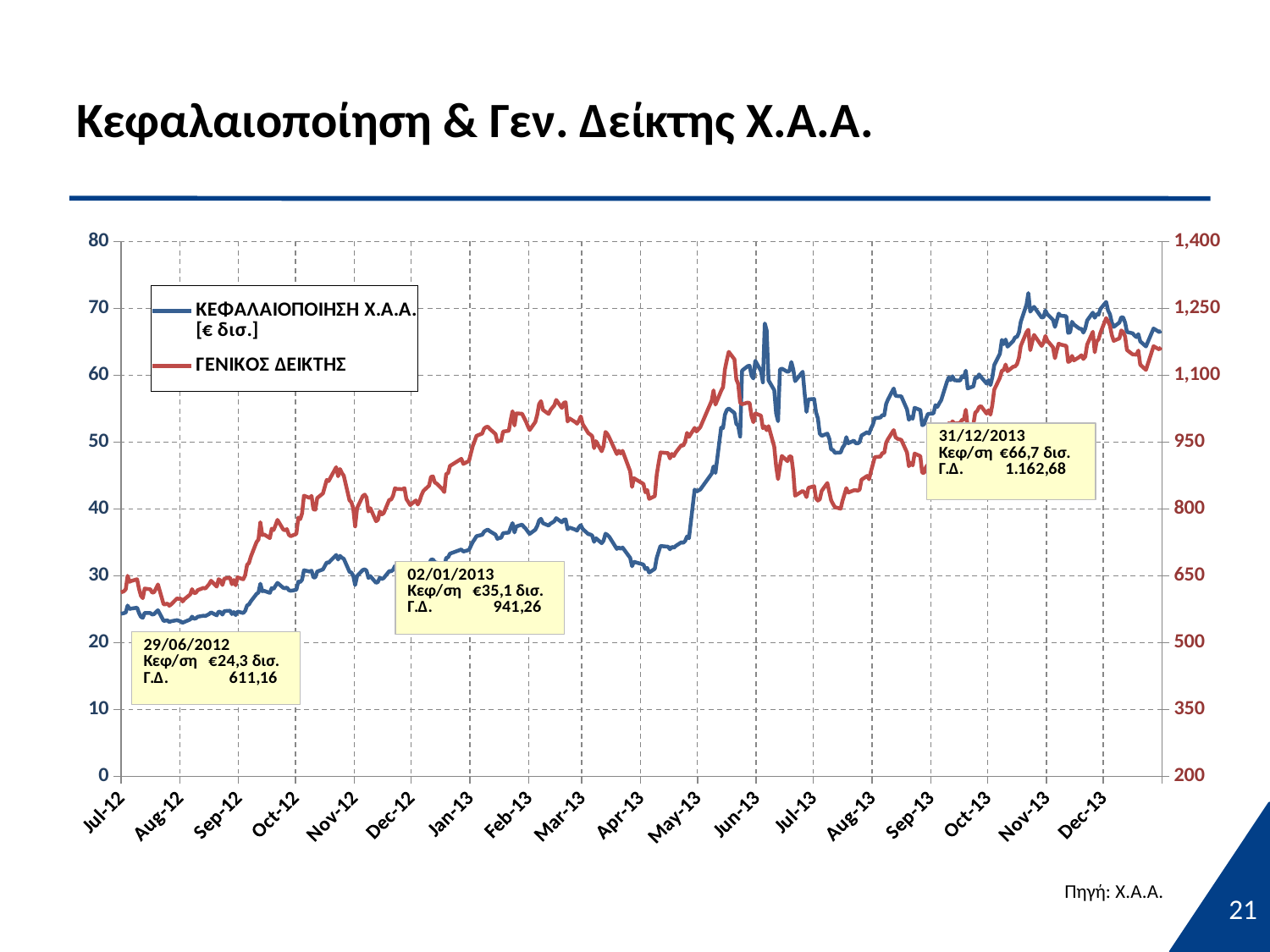
What was the General Index (Γ.Δ.) value on 02/01/2013 according to the annotation? 941,26 Which series is drawn in red in the chart? ΓΕΝΙΚΟΣ ΔΕΙΚΤΗΣ How many series does the legend list? 2 What was the capitalisation (Κεφ/ση) on 29/06/2012 according to the annotation? €24,3 δισ. Overall, does the ΚΕΦΑΛΑΙΟΠΟΙΗΣΗ Χ.Α.Α. line rise or fall from Jul-12 to Dec-13? rise What type of chart is shown on the slide? line chart What was the General Index (Γ.Δ.) value on 29/06/2012 according to the annotation? 611,16 Which annotated date shows the higher General Index value, 02/01/2013 or 31/12/2013? 31/12/2013 By how much did the capitalisation increase between 29/06/2012 and 31/12/2013, based on the annotated values? €42,4 δισ. What was the capitalisation (Κεφ/ση) on 31/12/2013 according to the annotation? €66,7 δισ. What was the General Index (Γ.Δ.) value on 31/12/2013 according to the annotation? 1.162,68 What was the capitalisation (Κεφ/ση) on 02/01/2013 according to the annotation? €35,1 δισ.